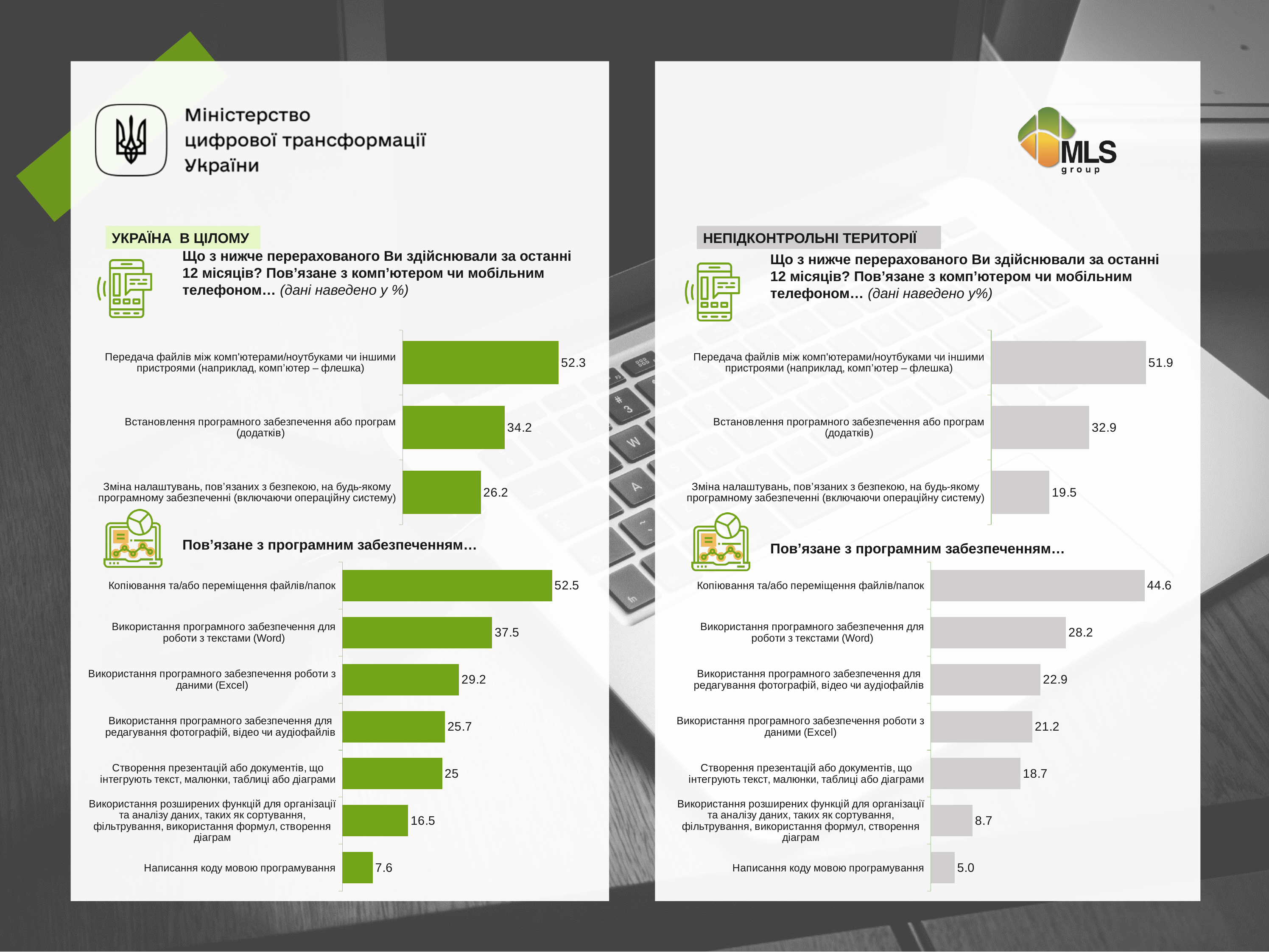
How many categories are shown in the top chart of the 'УКРАЇНА В ЦІЛОМУ' panel? 3 In the 'УКРАЇНА В ЦІЛОМУ' panel, bottom chart, what is the value for 'Написання коду мовою програмування'? 7.6 In the 'НЕПІДКОНТРОЛЬНІ ТЕРИТОРІЇ' panel, bottom chart, what is the value for 'Використання розширених функцій для організації та аналізу даних'? 8.7 Comparing the top charts of the two panels, which is larger: the value for 'Встановлення програмного забезпечення або програм (додатків)' in 'УКРАЇНА В ЦІЛОМУ' or in 'НЕПІДКОНТРОЛЬНІ ТЕРИТОРІЇ'? УКРАЇНА В ЦІЛОМУ (34.2) In the 'УКРАЇНА В ЦІЛОМУ' panel, bottom chart ('Пов'язане з програмним забезпеченням…'), which category has the highest value? Копіювання та/або переміщення файлів/папок What type of chart is used in the 'УКРАЇНА В ЦІЛОМУ' panel? Bar chart In the 'УКРАЇНА В ЦІЛОМУ' panel, top chart (computer or mobile phone related), what is the value for 'Передача файлів між комп'ютерами/ноутбуками чи іншими пристроями'? 52.3 In the 'НЕПІДКОНТРОЛЬНІ ТЕРИТОРІЇ' panel, top chart (computer or mobile phone related), what is the value for 'Зміна налаштувань, пов'язаних з безпекою'? 19.5 What colour are the bars in the 'НЕПІДКОНТРОЛЬНІ ТЕРИТОРІЇ' panel charts? Grey How many categories are shown in the bottom chart ('Пов'язане з програмним забезпеченням…') of the 'НЕПІДКОНТРОЛЬНІ ТЕРИТОРІЇ' panel? 7 In the 'НЕПІДКОНТРОЛЬНІ ТЕРИТОРІЇ' panel, bottom chart ('Пов'язане з програмним забезпеченням…'), which category has the lowest value? Написання коду мовою програмування In the 'УКРАЇНА В ЦІЛОМУ' panel, bottom chart, what is the difference between the values for 'Використання програмного забезпечення для роботи з текстами (Word)' and 'Використання програмного забезпечення роботи з даними (Excel)'? 8.3